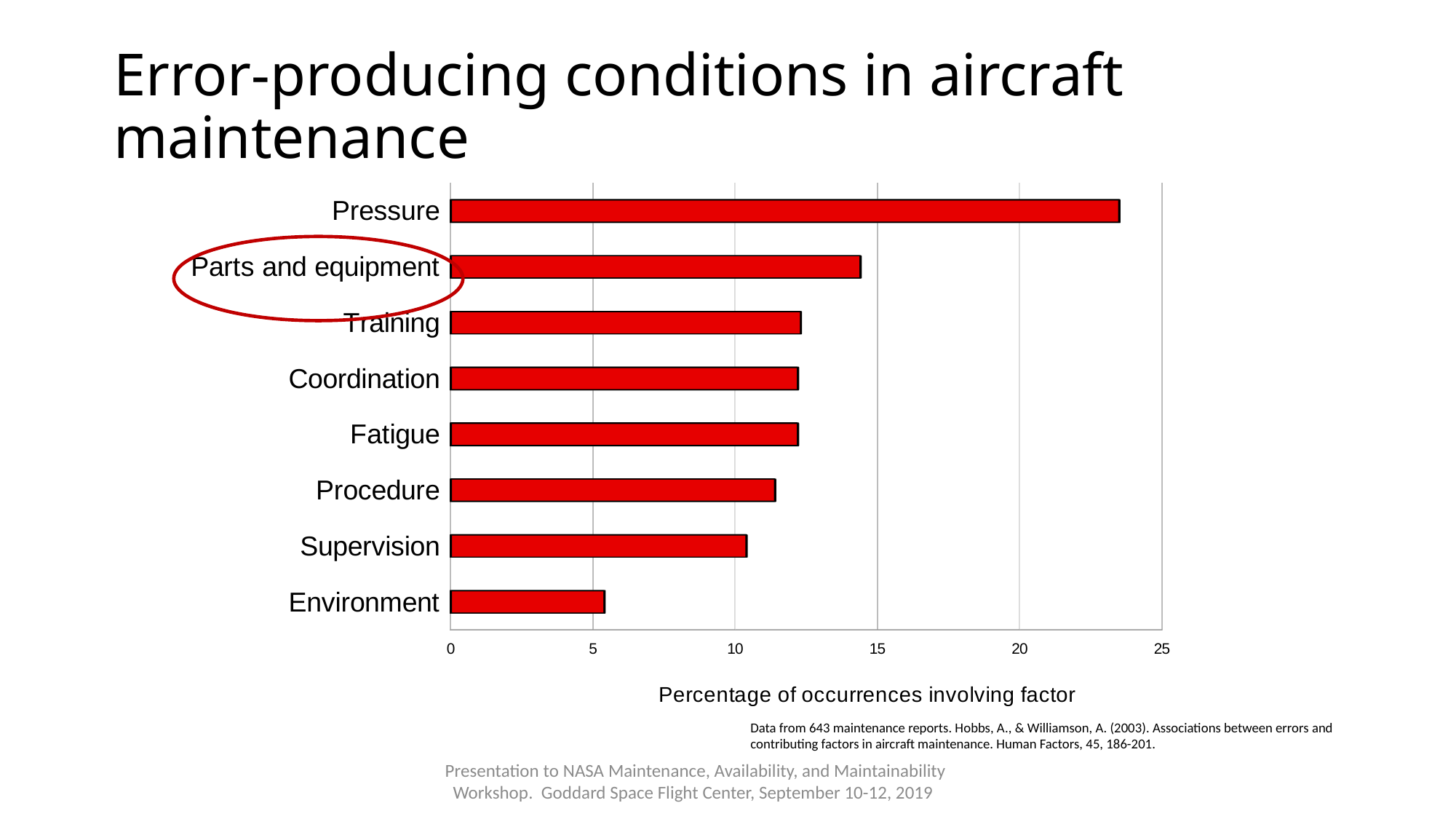
Which is larger, the value for Supervision or the value for Environment? Supervision Which category has the highest percentage of occurrences involving the factor? Pressure Which category has the lowest percentage of occurrences involving the factor? Environment Is the value for Procedure greater or less than 10? greater Is the value for Parts and equipment greater or less than 15? less What kind of chart is shown on the slide? bar chart Is the value for Environment greater or less than 10? less Which is larger, the value for Pressure or the value for Parts and equipment? Pressure Which category label is circled in red on the chart? Parts and equipment What is the label on the horizontal axis of the chart? Percentage of occurrences involving factor How many categories are plotted in the chart? 8